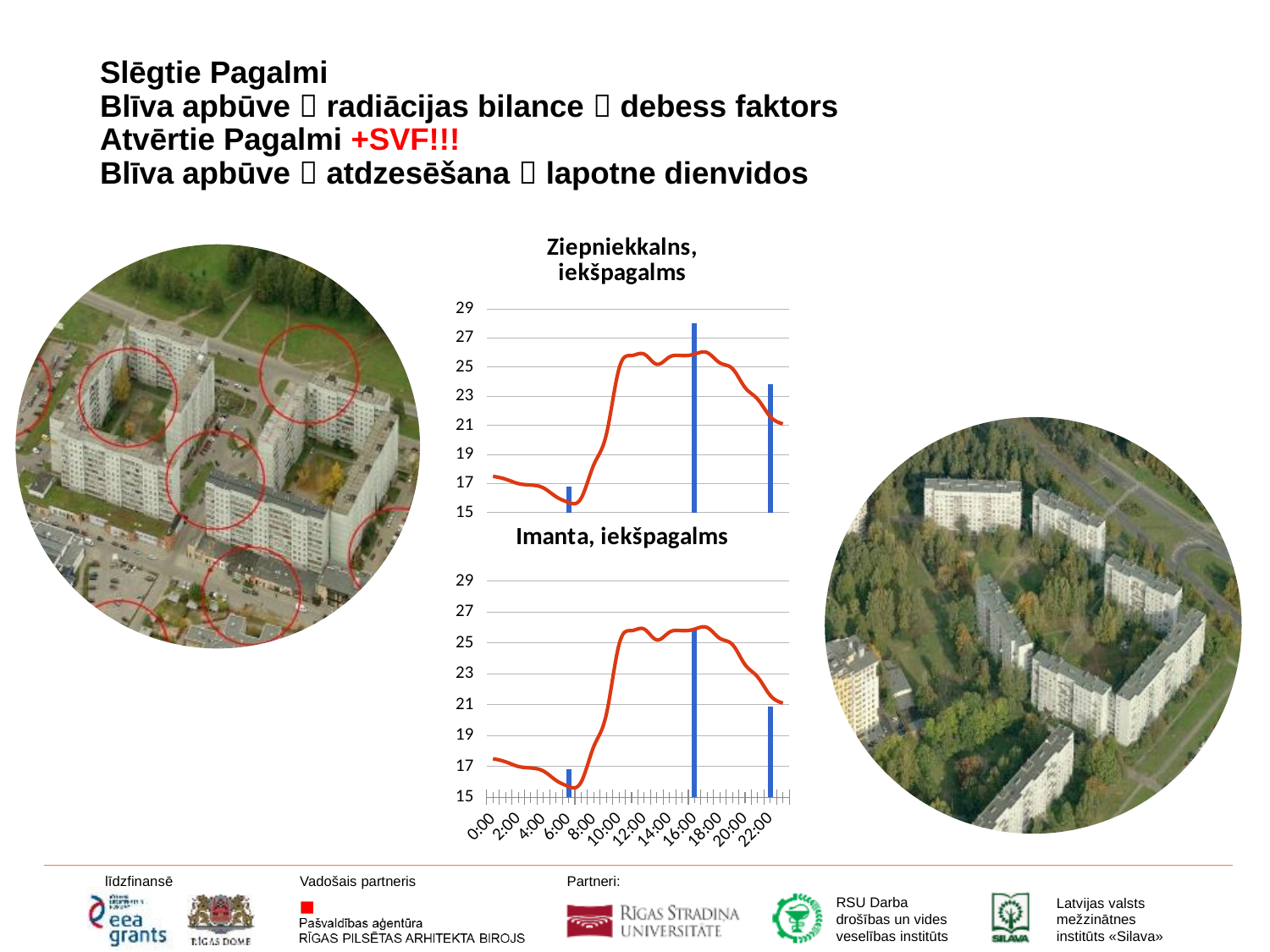
What kind of chart is the 'Ziepniekkalns, iekšpagalms' chart? combination bar and line chart What is the highest value shown on the y axis of the 'Imanta, iekšpagalms' chart? 29 In the 'Ziepniekkalns, iekšpagalms' chart, is the red line value at 6:00 greater or less than 17? less In the 'Ziepniekkalns, iekšpagalms' chart, is the blue bar at 16:00 greater or less than 27? greater In the 'Ziepniekkalns, iekšpagalms' chart, does the red line rise or fall between 18:00 and 22:00? fall In the 'Imanta, iekšpagalms' chart, is the blue bar at 16:00 greater or less than 23? greater In the 'Imanta, iekšpagalms' chart, how many time labels are shown on the x axis? 12 In the 'Imanta, iekšpagalms' chart, does the red line rise or fall between 6:00 and 12:00? rise What is the title of the lower chart on the slide? Imanta, iekšpagalms